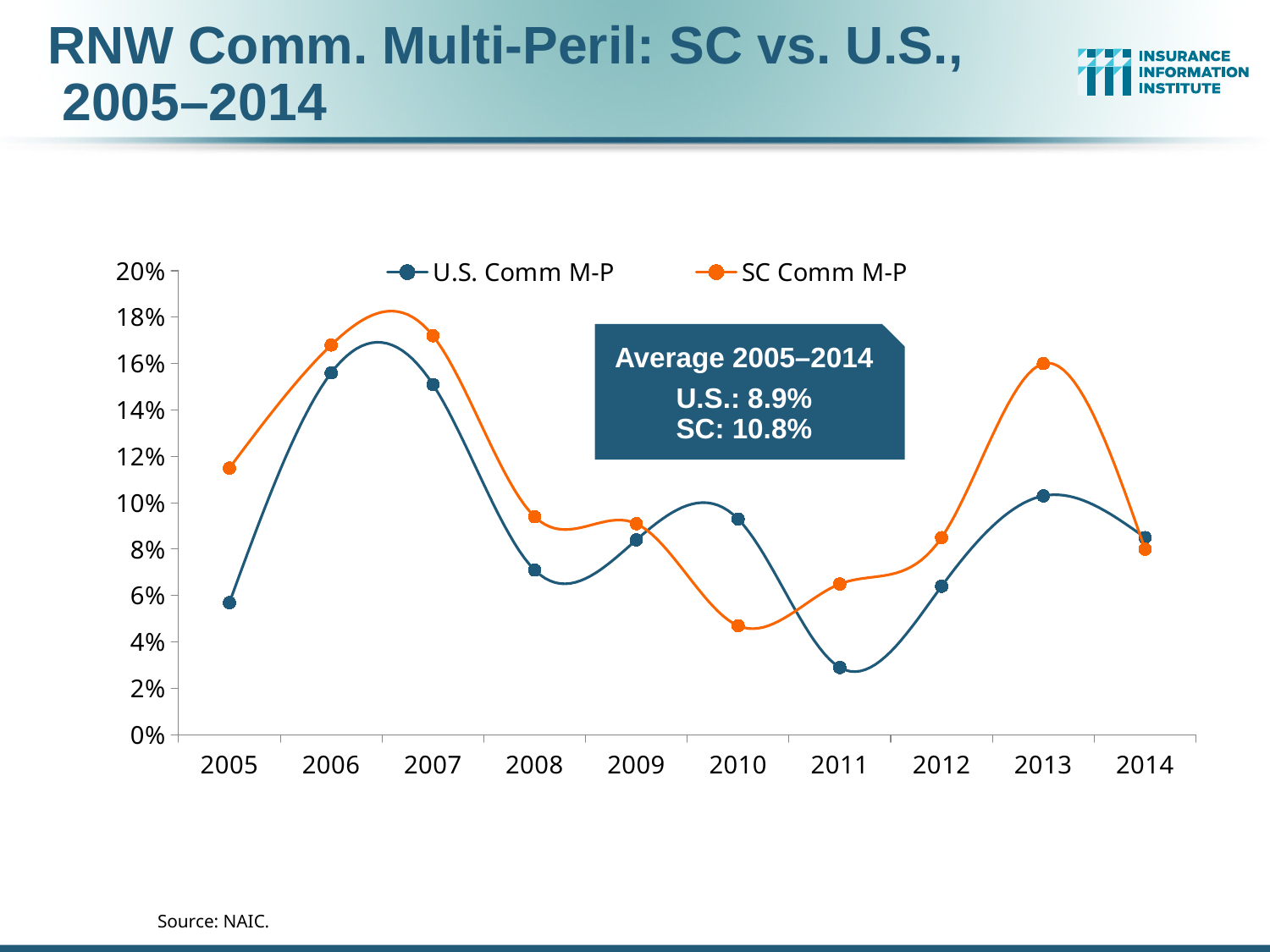
How many series does the legend list? 2 Does the U.S. Comm M-P value rise or fall from 2011 to 2013? rise What kind of chart is shown on the slide? line chart In which year is the U.S. Comm M-P value lowest? 2011 How many years are plotted along the x axis? 10 In 2010, which series has the larger value, U.S. Comm M-P or SC Comm M-P? U.S. Comm M-P Is the SC Comm M-P value for 2013 greater or less than 14%? greater According to the text box, what is the SC average for 2005–2014? 10.8% Is the U.S. Comm M-P value for 2011 greater or less than 4%? less In which year is the SC Comm M-P value lowest? 2010 According to the text box, what is the U.S. average for 2005–2014? 8.9% Is the SC Comm M-P value for 2005 greater or less than 10%? greater